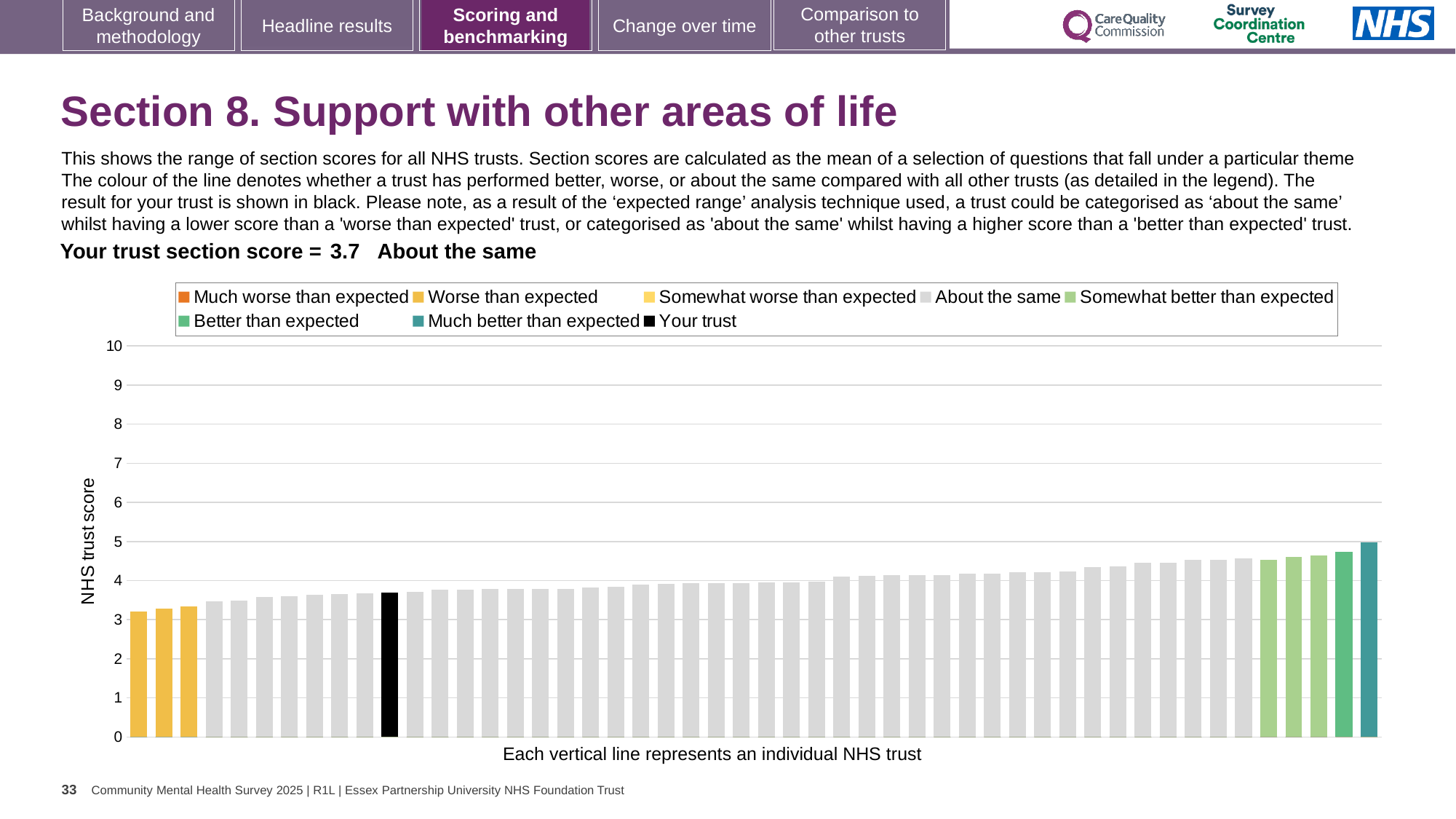
Is the value of the lowest bar greater or less than 3? greater Is the value of the highest bar greater or less than 4? greater What kind of chart is shown on the slide? bar chart How many bars are coloured as 'Worse than expected'? 3 Is the value of the highest bar greater or less than 6? less Do the bar values rise or fall from left to right along the x axis? rise How many entries does the chart legend list? 8 What is the label on the y axis of the chart? NHS trust score Which legend category does the highest-scoring trust belong to? Much better than expected What is the section score for your trust? 3.7 Which category is your trust placed in for this section? About the same